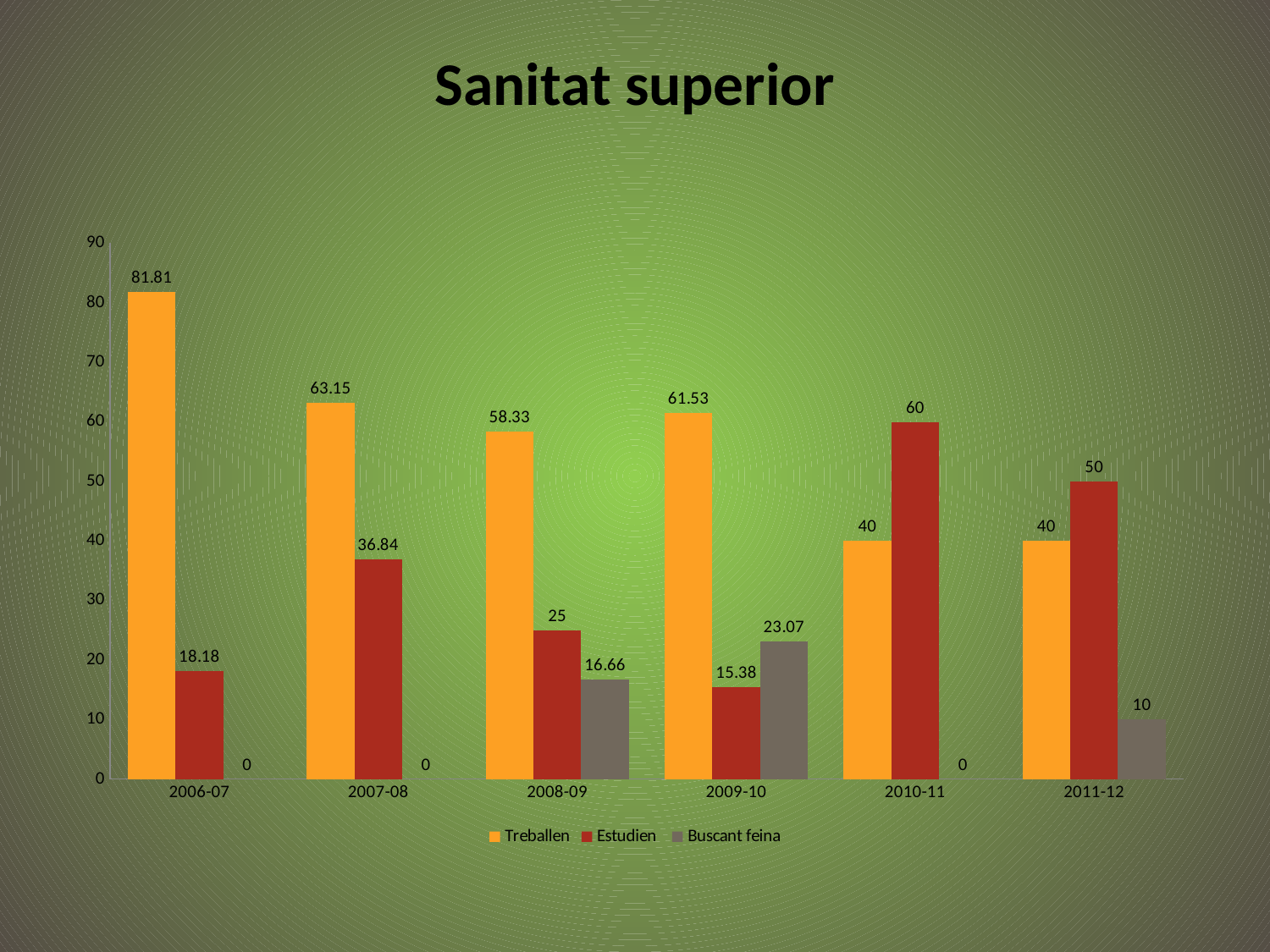
What is the value for Treballen in 2006-07? 81.81 Which year has the lowest value for Estudien? 2009-10 What is the value for Buscant feina in 2009-10? 23.07 Which year has the highest value for Treballen? 2006-07 What is the title of the chart? Sanitat superior Which is larger in 2011-12, Treballen or Estudien? Estudien What kind of chart is shown on the slide? bar chart How many series does the legend list? 3 How many years are shown on the x axis? 6 What is the difference between Treballen and Estudien in 2010-11? 20 Is the value for Treballen in 2008-09 greater or less than 50? greater What is the value for Estudien in 2007-08? 36.84